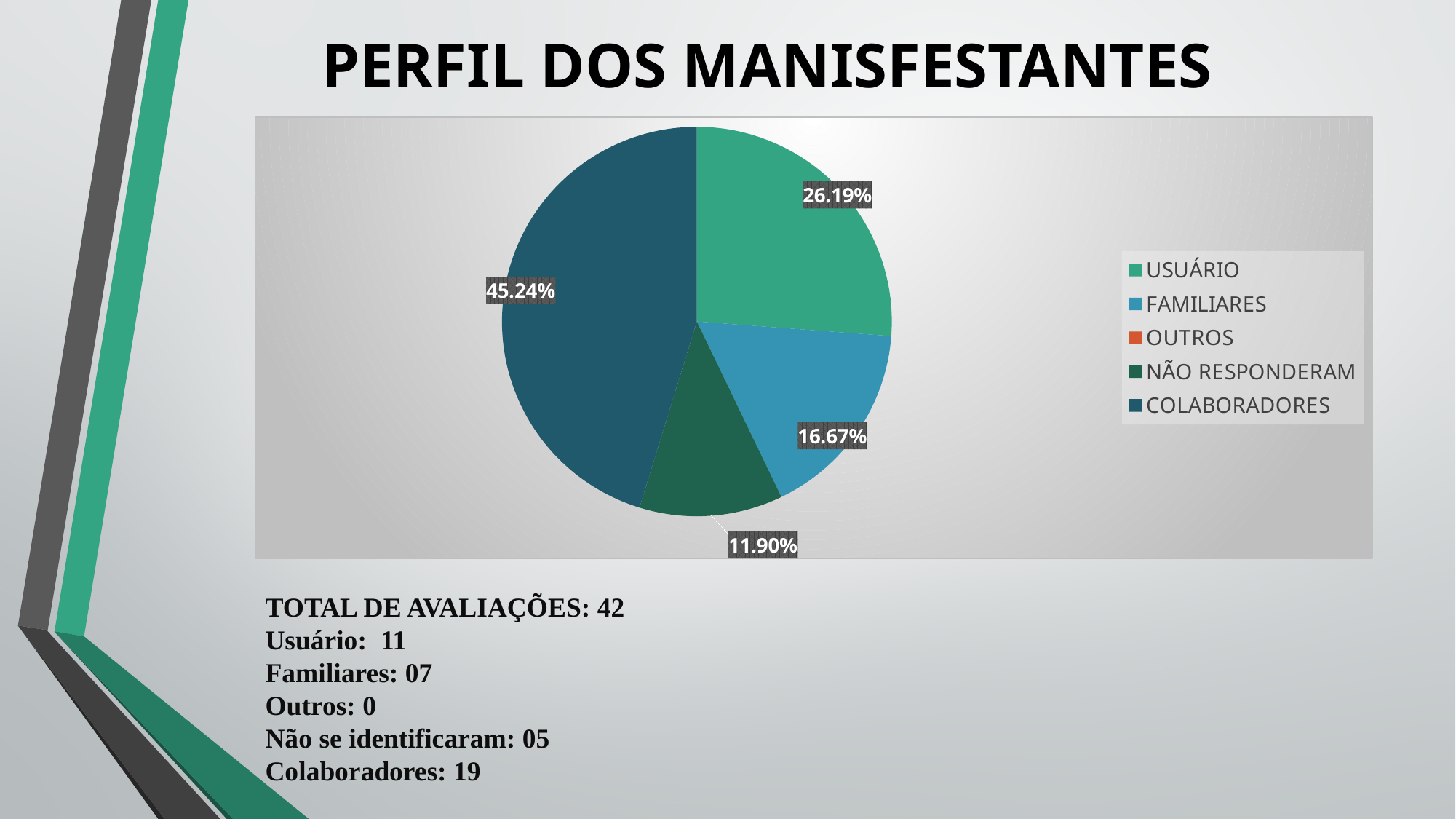
Which category with a visible slice has the smallest share of the pie? NÃO RESPONDERAM What percentage is shown for the NÃO RESPONDERAM slice? 11.90% How many entries does the legend list? 5 What percentage is shown for the FAMILIARES slice? 16.67% What percentage of the pie does the USUÁRIO slice represent? 26.19% What percentage is shown for the COLABORADORES slice? 45.24% Which legend entry is shown in orange? OUTROS What kind of chart is shown on the slide? pie chart Which category has the largest slice of the pie? COLABORADORES What is the difference in percentage points between the COLABORADORES slice and the USUÁRIO slice? 19.05 Which slice is larger, USUÁRIO or FAMILIARES? USUÁRIO Is the COLABORADORES share greater or less than 40%? greater